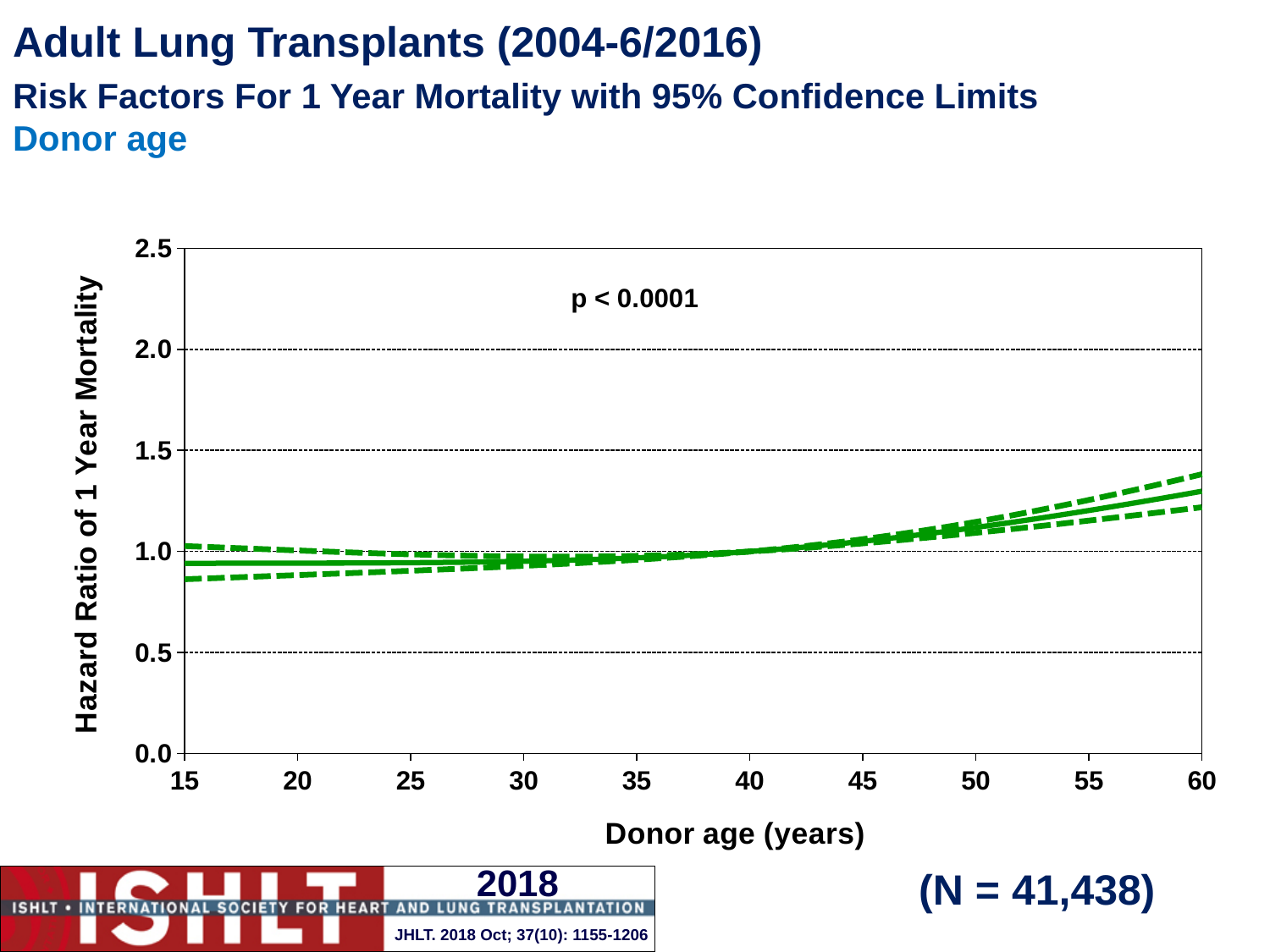
Is the hazard ratio at a donor age of 60 years greater or less than 1.5? less Is the upper 95% confidence limit at a donor age of 60 years greater or less than 1.5? less Does the hazard ratio of 1 year mortality rise or fall as donor age increases from 15 to 60 years? rise What p-value is printed on the chart? p < 0.0001 Which has the larger hazard ratio: a donor age of 15 years or a donor age of 60 years? 60 years Is the hazard ratio at a donor age of 55 years greater or less than 1.0? greater What kind of chart is shown on the slide? line chart What sample size (N) is shown on the slide? N = 41,438 At which donor age shown on the x axis is the hazard ratio highest? 60